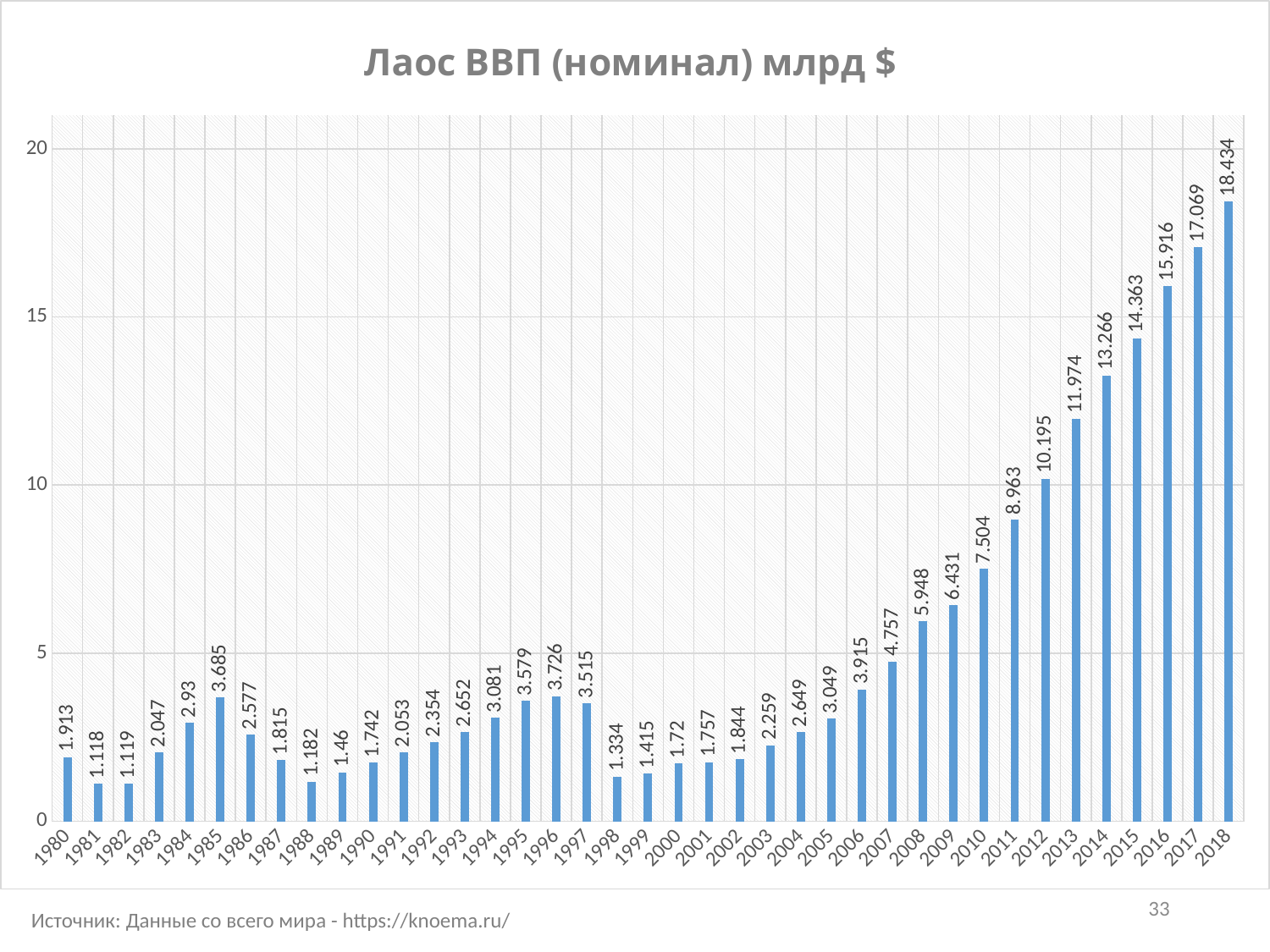
Is the value for 2016 greater or less than 15? greater What is the value for 1980? 1.913 What is the value for 2000? 1.72 Which is larger, the value for 2005 or the value for 2006? 2006 Which year has the highest value? 2018 Do the values generally rise or fall from 2000 to 2018? Rise What is the title of the chart? Лаос ВВП (номинал) млрд $ What is the value for 2018? 18.434 What is the value for 2010? 7.504 What type of chart is shown on the slide? Bar chart What is the difference between the values for 2018 and 2017? 1.365 How many years (bars) are plotted in the chart? 39